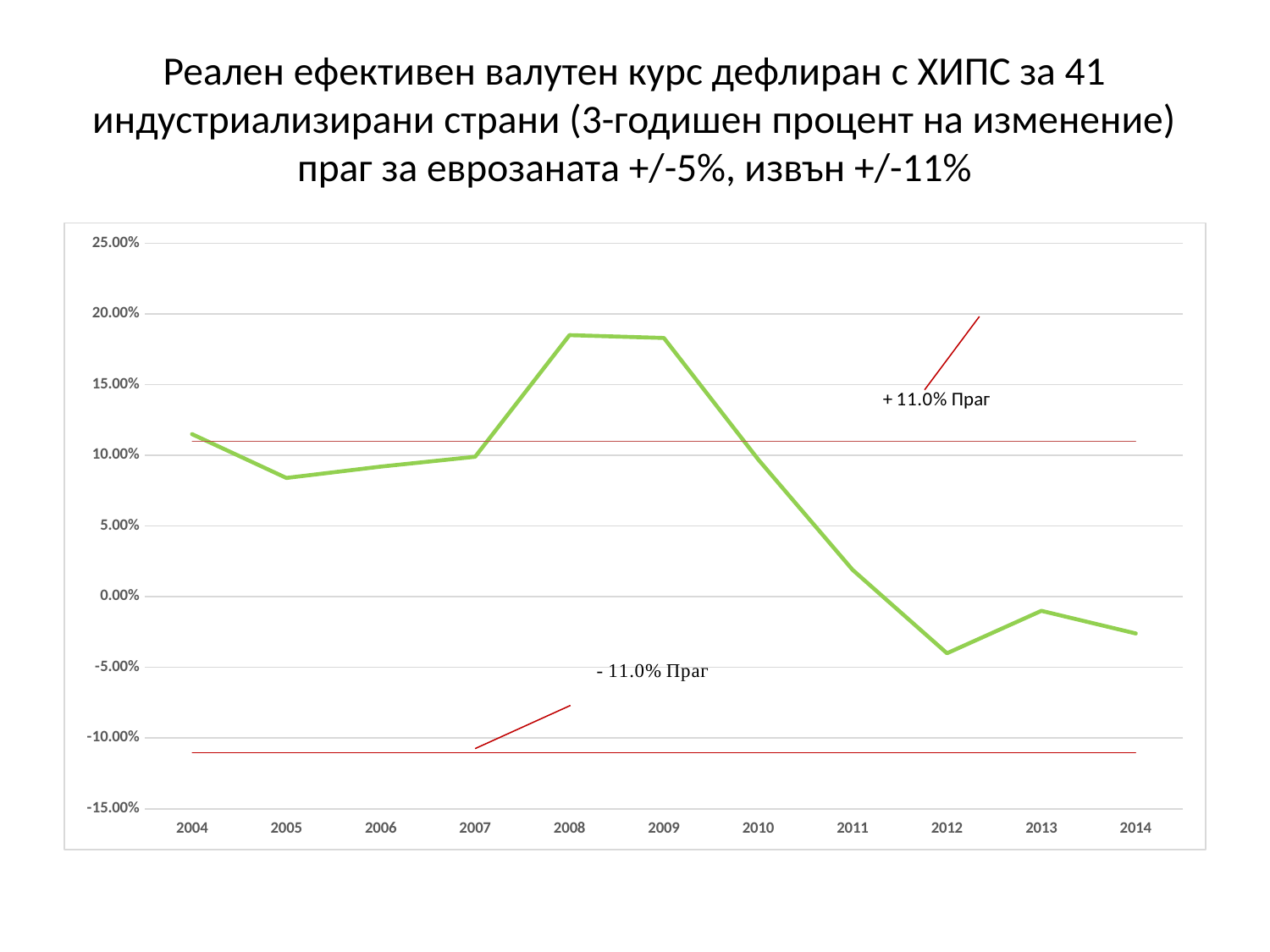
Is the value for 2008 greater or less than 15.00%? greater Is the value for 2011 greater or less than 5.00%? less What kind of chart is shown on the slide? line chart How many years are plotted along the x axis? 11 Is the value for 2005 greater or less than 5.00%? greater Which year has the lowest value on the chart? 2012 Which year has the larger value, 2008 or 2005? 2008 What is the label of the upper horizontal threshold line on the chart? + 11.0% Праг Does the line rise or fall between 2009 and 2012? fall Which year has the larger value, 2012 or 2013? 2013